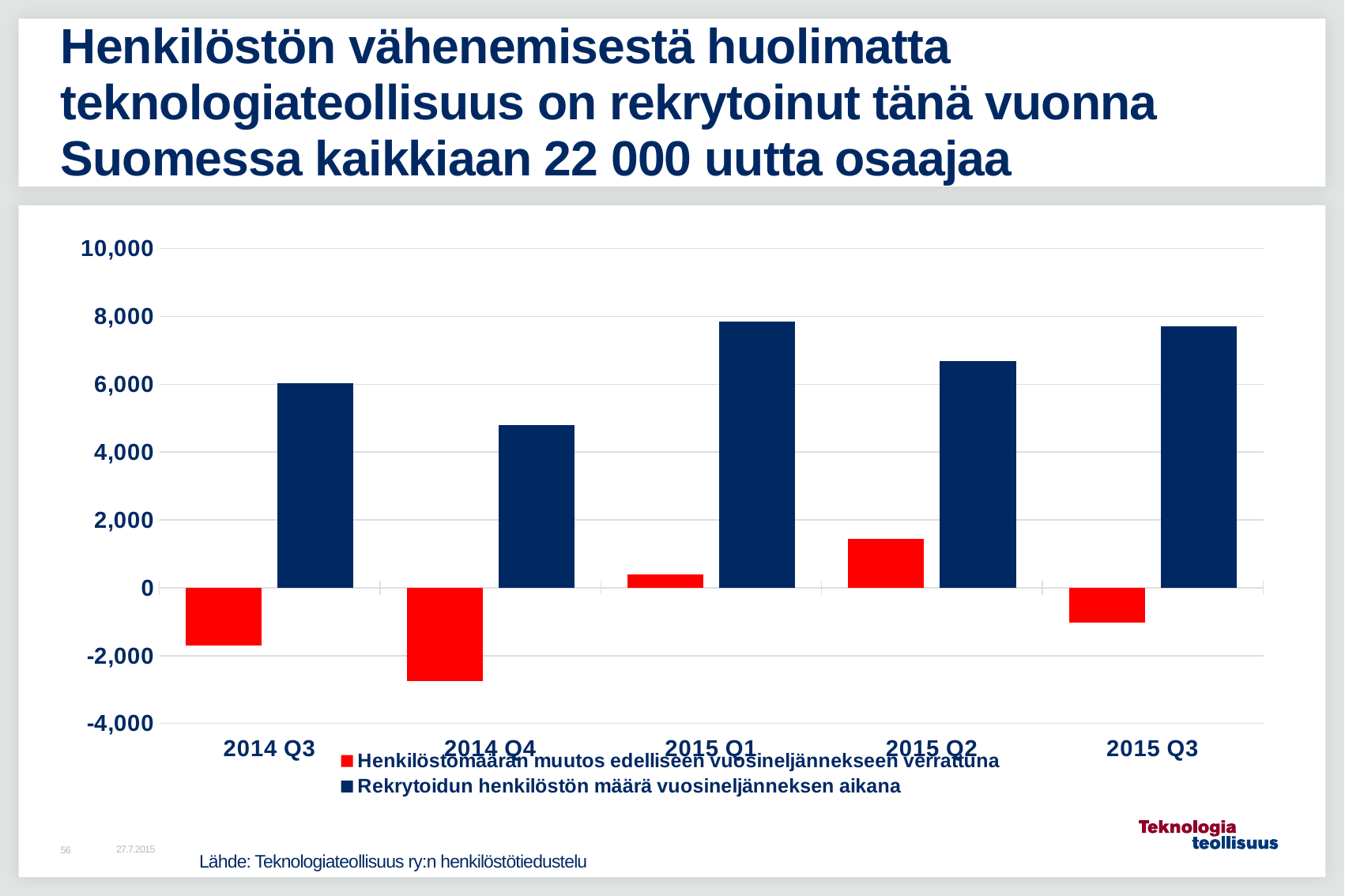
What kind of chart is shown on the slide? bar chart In which quarter is the value for 'Henkilöstömäärän muutos edelliseen vuosineljännekseen verrattuna' lowest? 2014 Q4 In which quarter is the value for 'Henkilöstömäärän muutos edelliseen vuosineljännekseen verrattuna' highest? 2015 Q2 Does the value for 'Rekrytoidun henkilöstön määrä vuosineljänneksen aikana' rise or fall from 2014 Q4 to 2015 Q1? rise In which quarter is the value for 'Rekrytoidun henkilöstön määrä vuosineljänneksen aikana' lowest? 2014 Q4 Is the value for 'Rekrytoidun henkilöstön määrä vuosineljänneksen aikana' in 2014 Q4 greater or less than 6,000? less What colour are the bars for 'Henkilöstömäärän muutos edelliseen vuosineljännekseen verrattuna'? red Is the value for 'Henkilöstömäärän muutos edelliseen vuosineljännekseen verrattuna' in 2014 Q4 greater or less than -2,000? less Which quarter has the larger value for 'Rekrytoidun henkilöstön määrä vuosineljänneksen aikana', 2014 Q3 or 2014 Q4? 2014 Q3 Is the value for 'Rekrytoidun henkilöstön määrä vuosineljänneksen aikana' in 2014 Q3 greater or less than 4,000? greater How many quarters are shown on the x axis of the chart? 5 How many series does the chart's legend list? 2